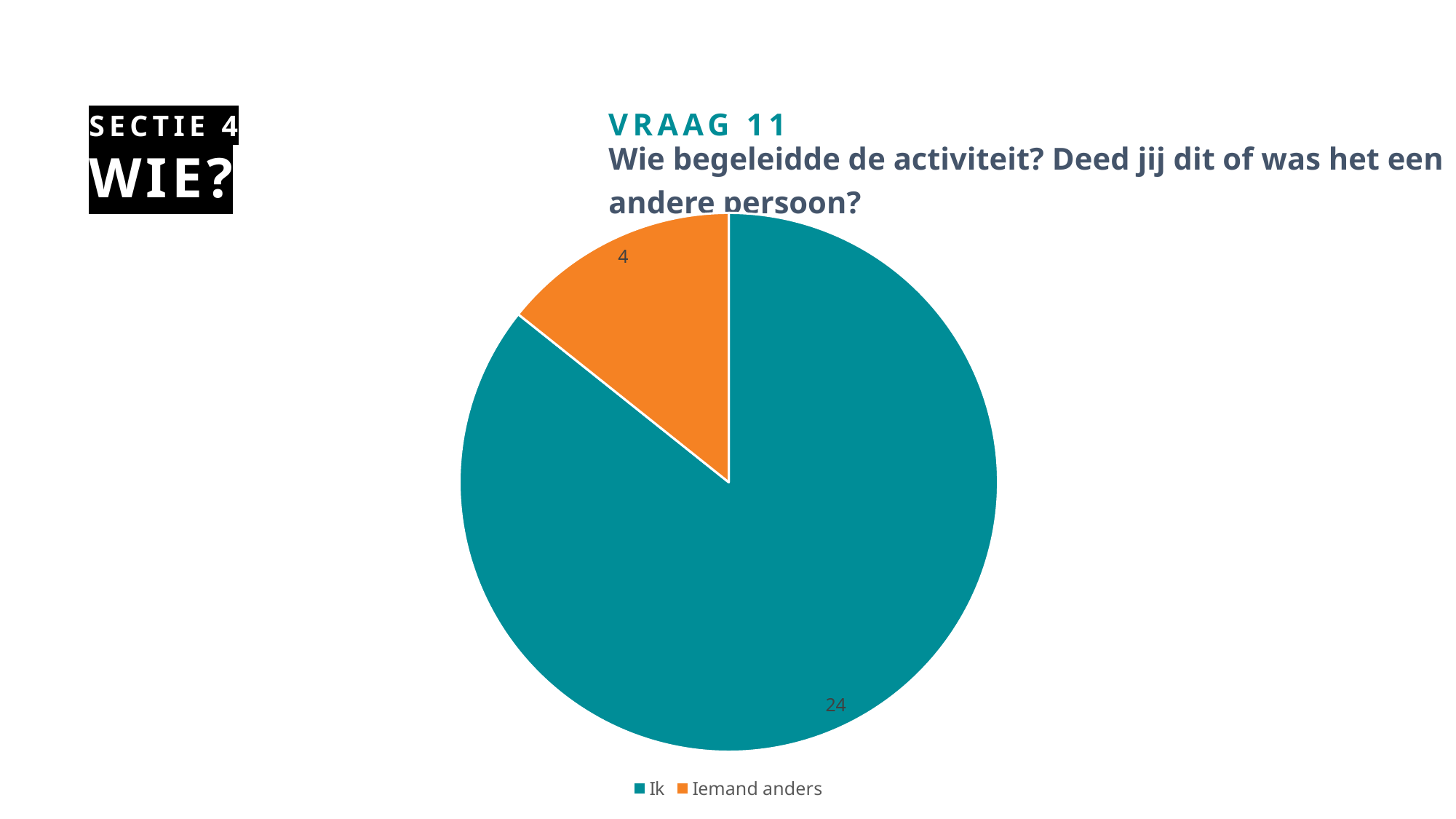
What is the total of all slices in the pie chart? 28 How many slices does the pie chart have? 2 What is the difference between the values for "Ik" and "Iemand anders"? 20 Which category has the largest slice? Ik Which category has the smallest slice? Iemand anders What colour is the slice for "Iemand anders"? orange What is the value for "Ik"? 24 How many entries does the legend list? 2 What is the value for "Iemand anders"? 4 Which is larger, the value for "Ik" or for "Iemand anders"? Ik What colour is the slice for "Ik"? teal What kind of chart is shown on the slide? pie chart